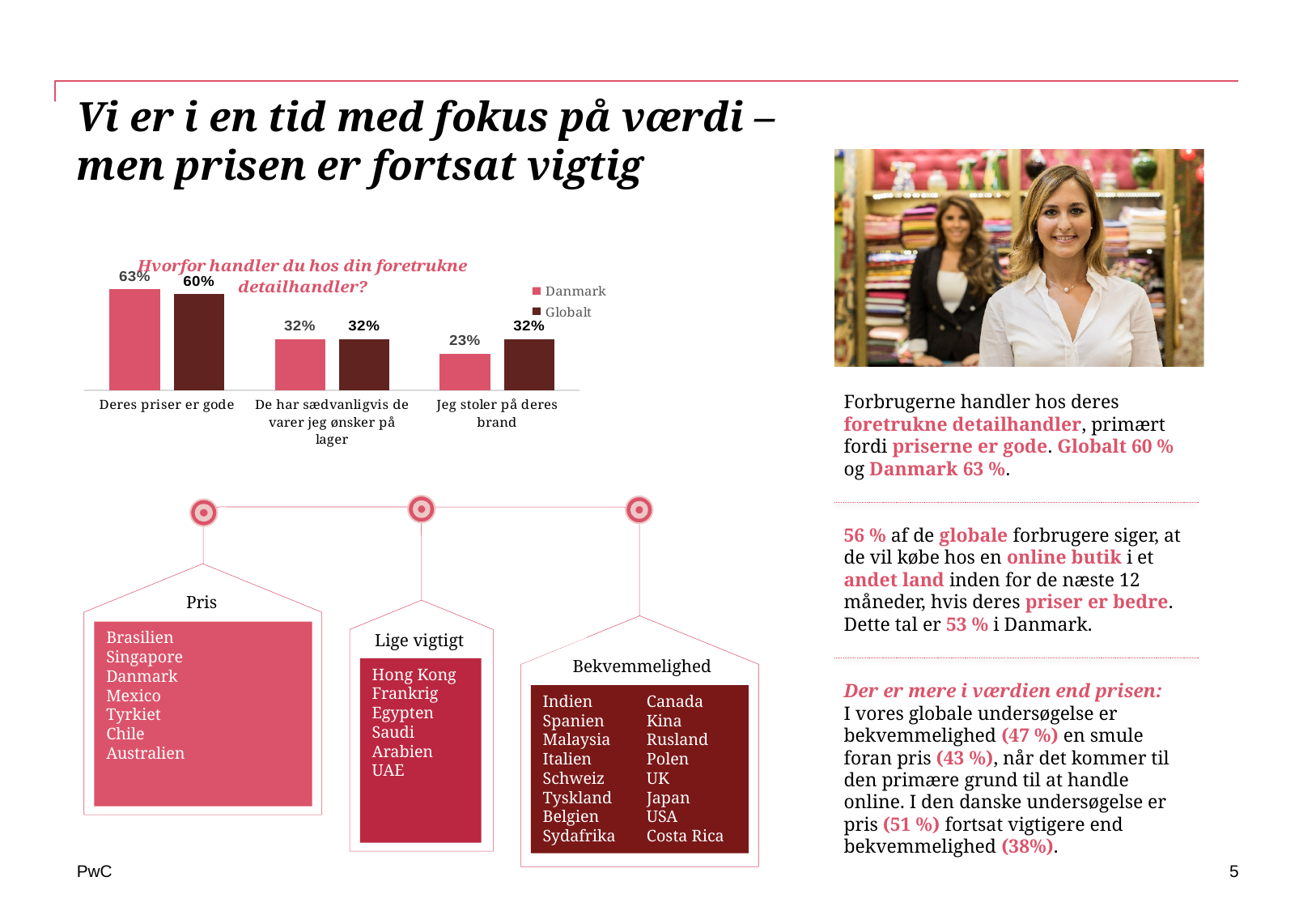
How many series does the chart legend list? 2 How many categories are shown on the x axis of the chart? 3 For "Deres priser er gode", which is larger: the Danmark value or the Globalt value? Danmark What is the Danmark value for "Jeg stoler på deres brand"? 23% What is the Globalt value for "Jeg stoler på deres brand"? 32% What type of chart is shown on the slide? Bar chart What is the Danmark value for "Deres priser er gode"? 63% Which category has the highest Danmark value? Deres priser er gode What is the difference between the Globalt and Danmark values for "Jeg stoler på deres brand"? 9 percentage points What is the Danmark value for "De har sædvanligvis de varer jeg ønsker på lager"? 32% What is the Globalt value for "Deres priser er gode"? 60% Which category has the lowest Danmark value? Jeg stoler på deres brand